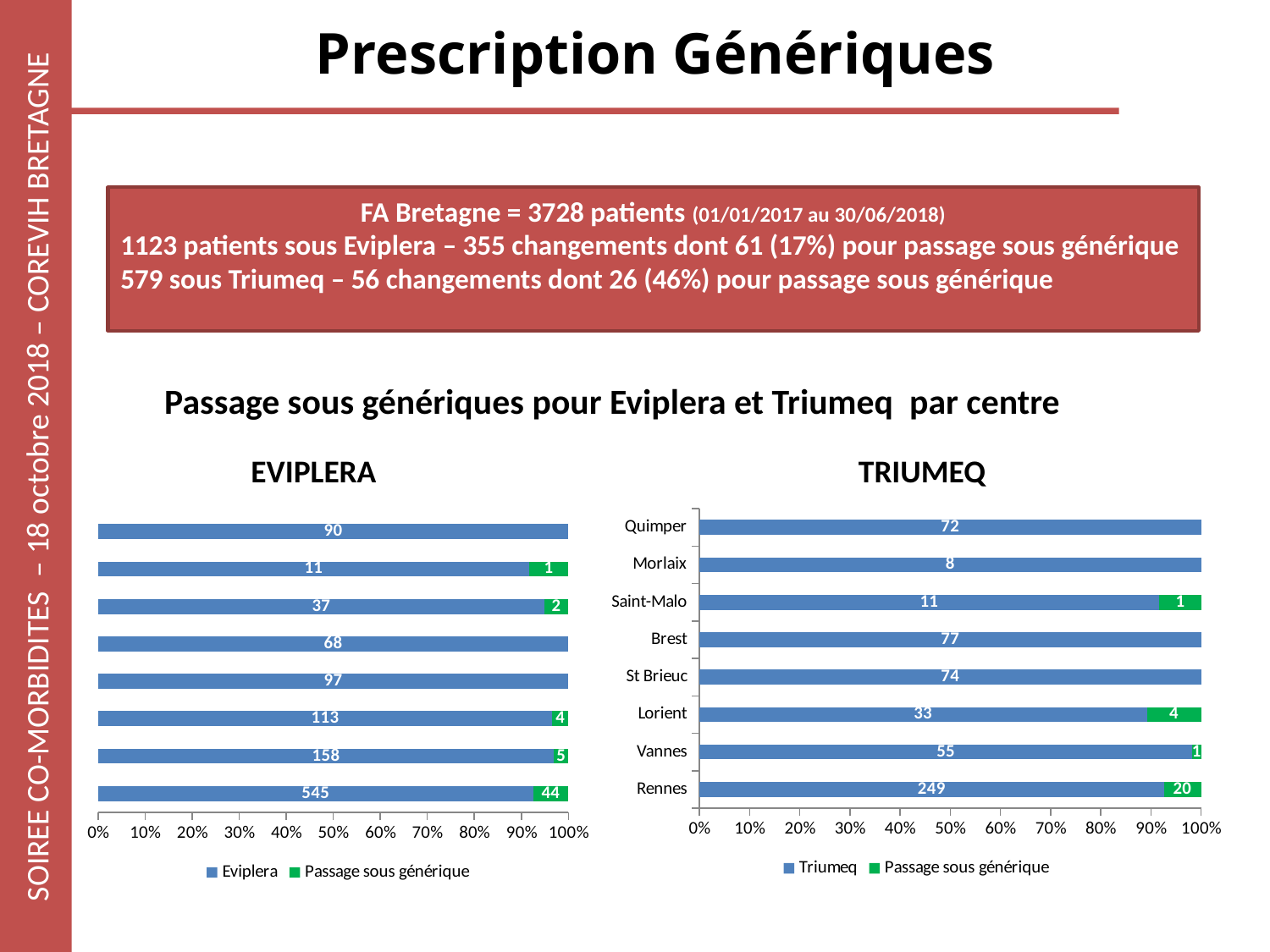
In the TRIUMEQ chart, what is the total of the stacked bar for Rennes? 269 In the TRIUMEQ chart, which centre has the lowest Triumeq value? Morlaix How many bars are shown in the EVIPLERA chart? 8 What are the two legend entries of the EVIPLERA chart? Eviplera and Passage sous générique In the TRIUMEQ chart, which centre has the highest Triumeq value? Rennes In the TRIUMEQ chart, which has the larger Triumeq value, Brest or St Brieuc? Brest What kind of chart is the EVIPLERA chart? Bar chart In the TRIUMEQ chart, what is the Triumeq value for Rennes? 249 How many centres are shown in the TRIUMEQ chart? 8 In the TRIUMEQ chart, what is the difference between the Triumeq values for Brest and Quimper? 5 In the TRIUMEQ chart, what is the 'Passage sous générique' value for Lorient? 4 How many series does the legend of the TRIUMEQ chart list? 2